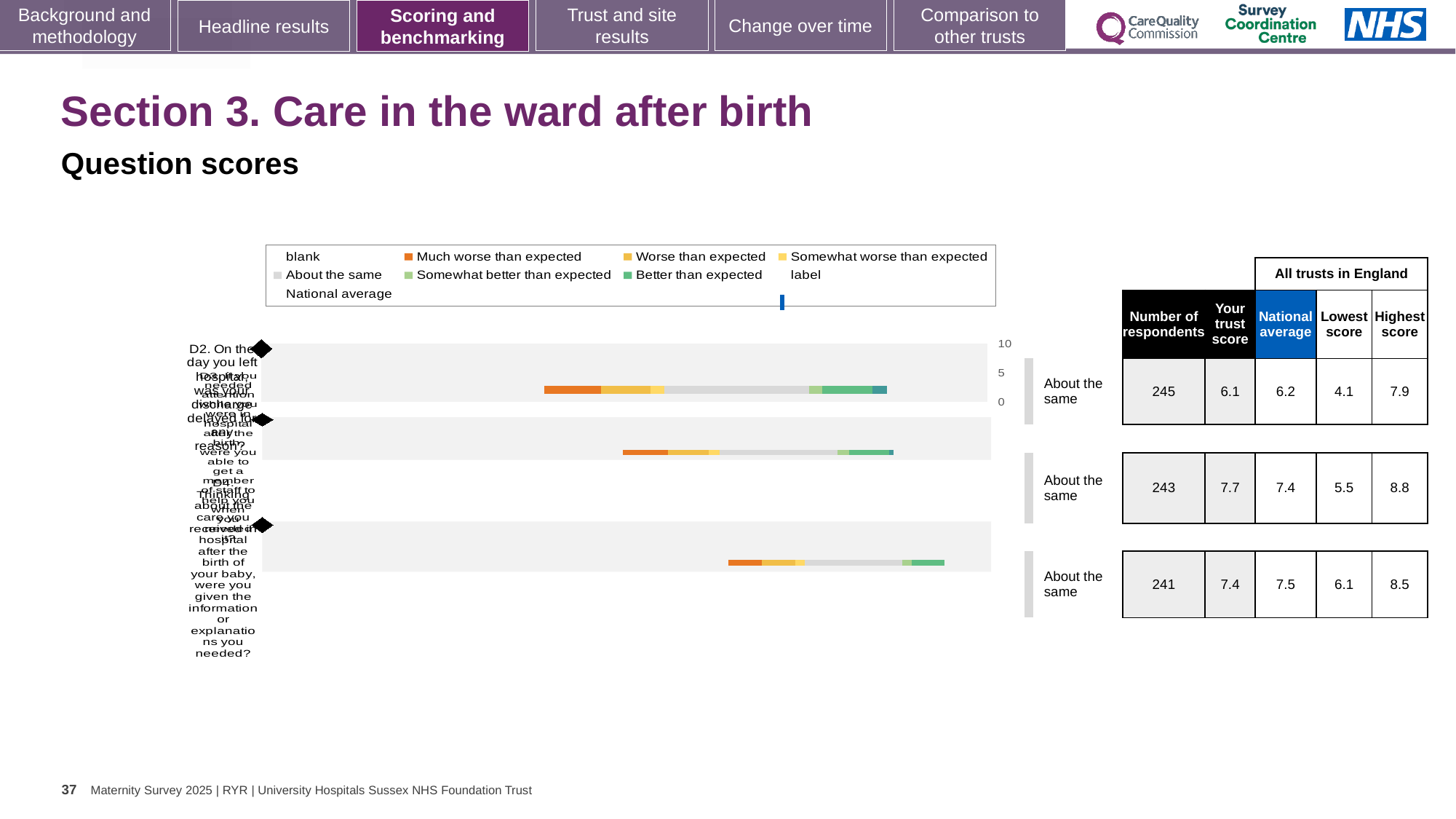
What kind of chart is shown on the slide? bar chart What is the highest value shown on the chart's axis? 10 What colour represents 'Much worse than expected' in the chart legend? orange In the table next to the chart, what is the highest score across all trusts in England for the second (middle) question? 8.8 For the second (middle) question in the table, what is the difference between 'Your trust score' and the national average? 0.3 Which of the three questions in the table has the highest 'Your trust score'? the second (middle) question In the table next to the chart, what is the number of respondents for the first (top) question? 245 How many question bars are plotted in the chart? 3 Which of the three questions in the table has the lowest number of respondents? the third (bottom) question In the table next to the chart, what is the national average for the third (bottom) question? 7.5 In the table next to the chart, what is 'Your trust score' for the second (middle) question? 7.7 In the table next to the chart, what is the lowest score across all trusts in England for the first (top) question? 4.1